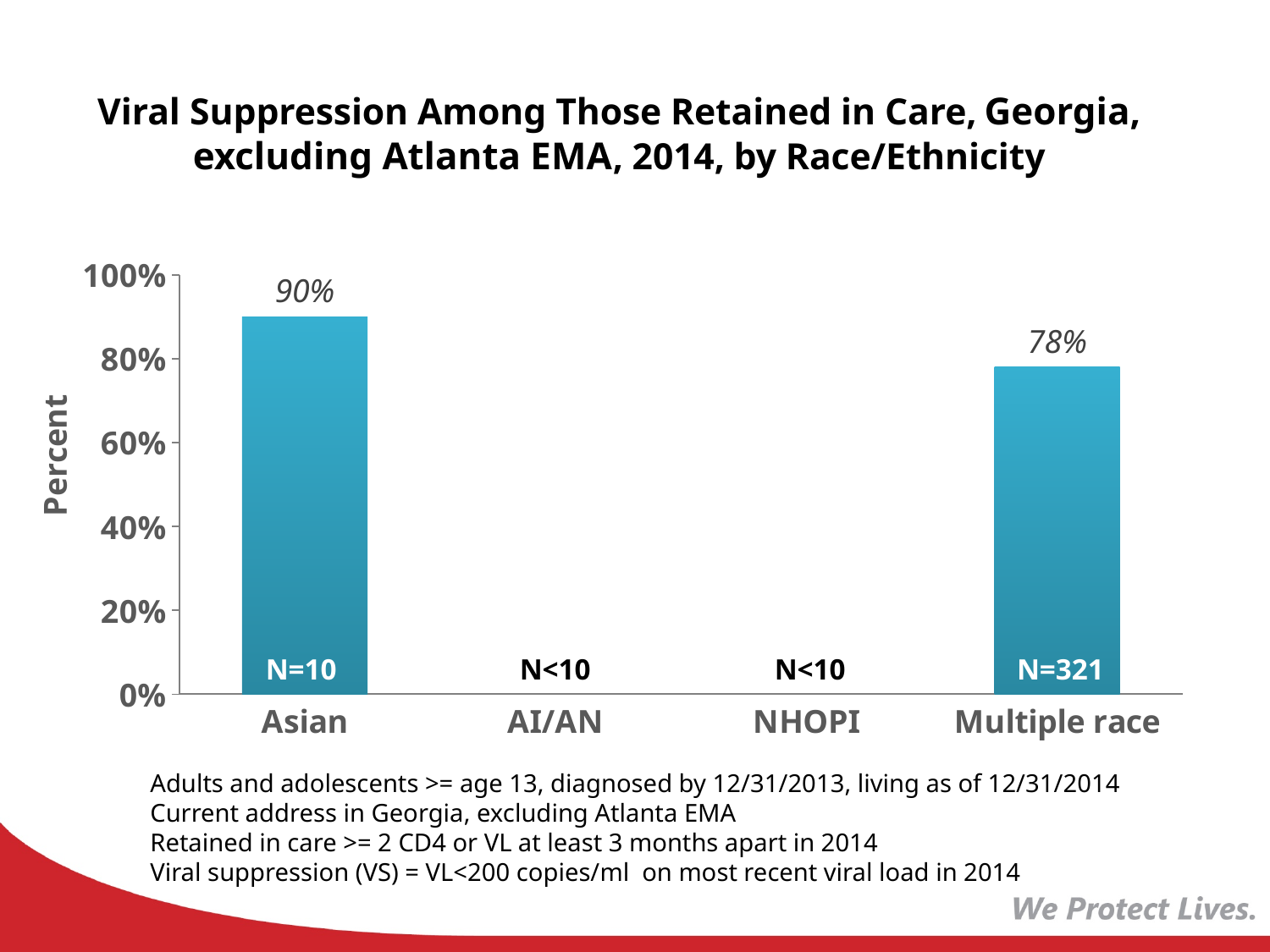
Is the value for Asian greater or less than 80%? greater What is the label on the y axis of the chart? Percent Which has a higher viral suppression percentage, Asian or Multiple race? Asian What is the N value shown for the Multiple race category? N=321 What is the viral suppression percentage for Multiple race? 78% Which race/ethnicity category has the highest viral suppression percentage shown? Asian How many race/ethnicity categories are shown on the x axis? 4 Is the value for Multiple race greater or less than 80%? less What kind of chart is shown on the slide? Bar chart What is the N value shown for the Asian category? N=10 What is the difference in viral suppression percentage between Asian and Multiple race? 12% What is the viral suppression percentage for Asian? 90%